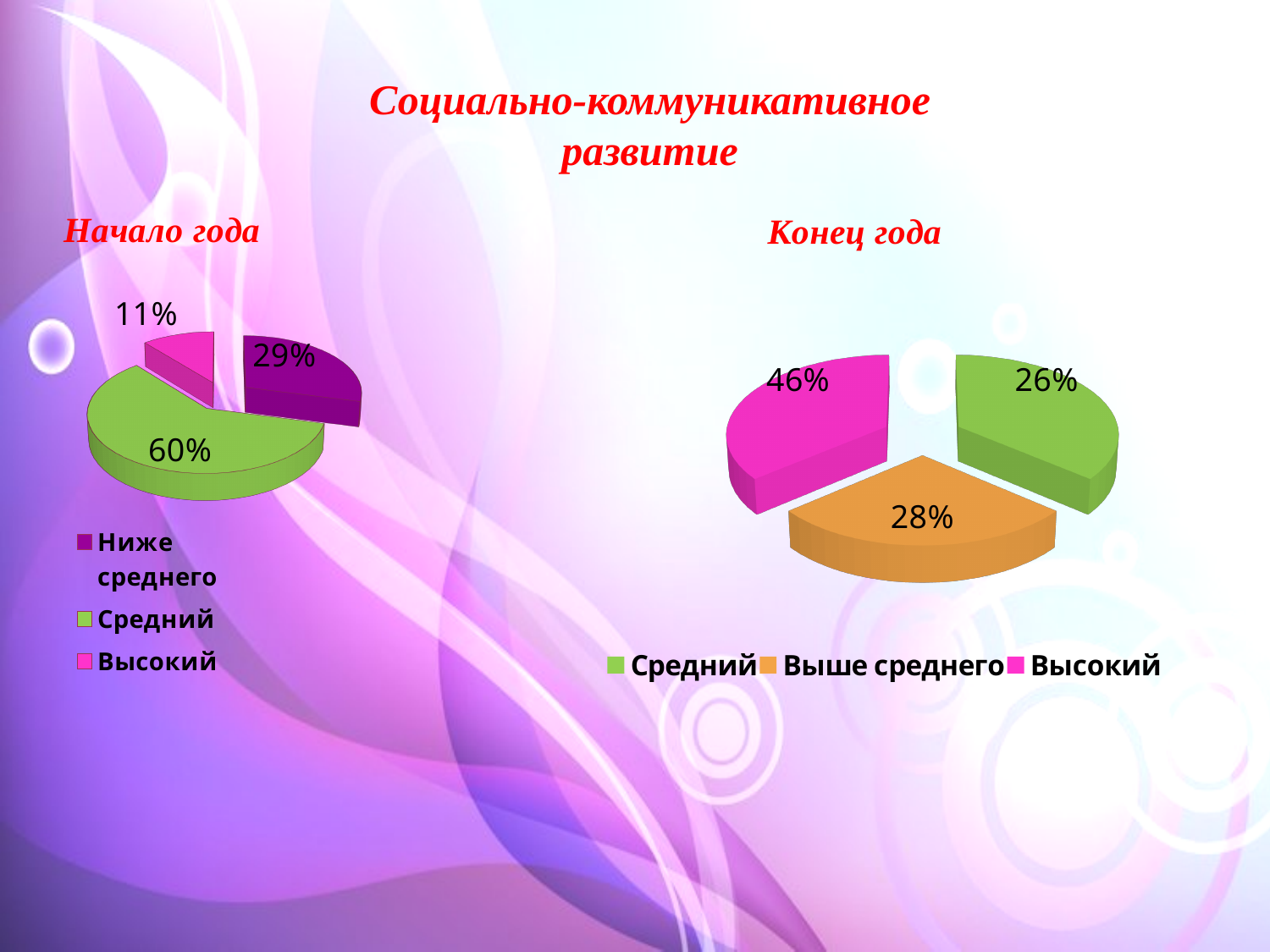
In the 'Конец года' chart, what is the difference between Высокий and Средний? 20% In the 'Начало года' chart, what is the value for Высокий? 11% In the 'Начало года' chart, what is the value for Средний? 60% In the 'Конец года' chart, what is the value for Высокий? 46% In the 'Конец года' chart, what is the value for Выше среднего? 28% What kind of chart is the 'Начало года' chart? Pie chart What are the legend entries of the 'Конец года' chart? Средний, Выше среднего, Высокий How many categories does the 'Конец года' chart show? 3 In the 'Начало года' chart, what is the value for Ниже среднего? 29% In the 'Конец года' chart, which category has the largest share? Высокий In the 'Начало года' chart, which category has the smallest share? Высокий In the 'Начало года' chart, which is larger: Ниже среднего or Высокий? Ниже среднего